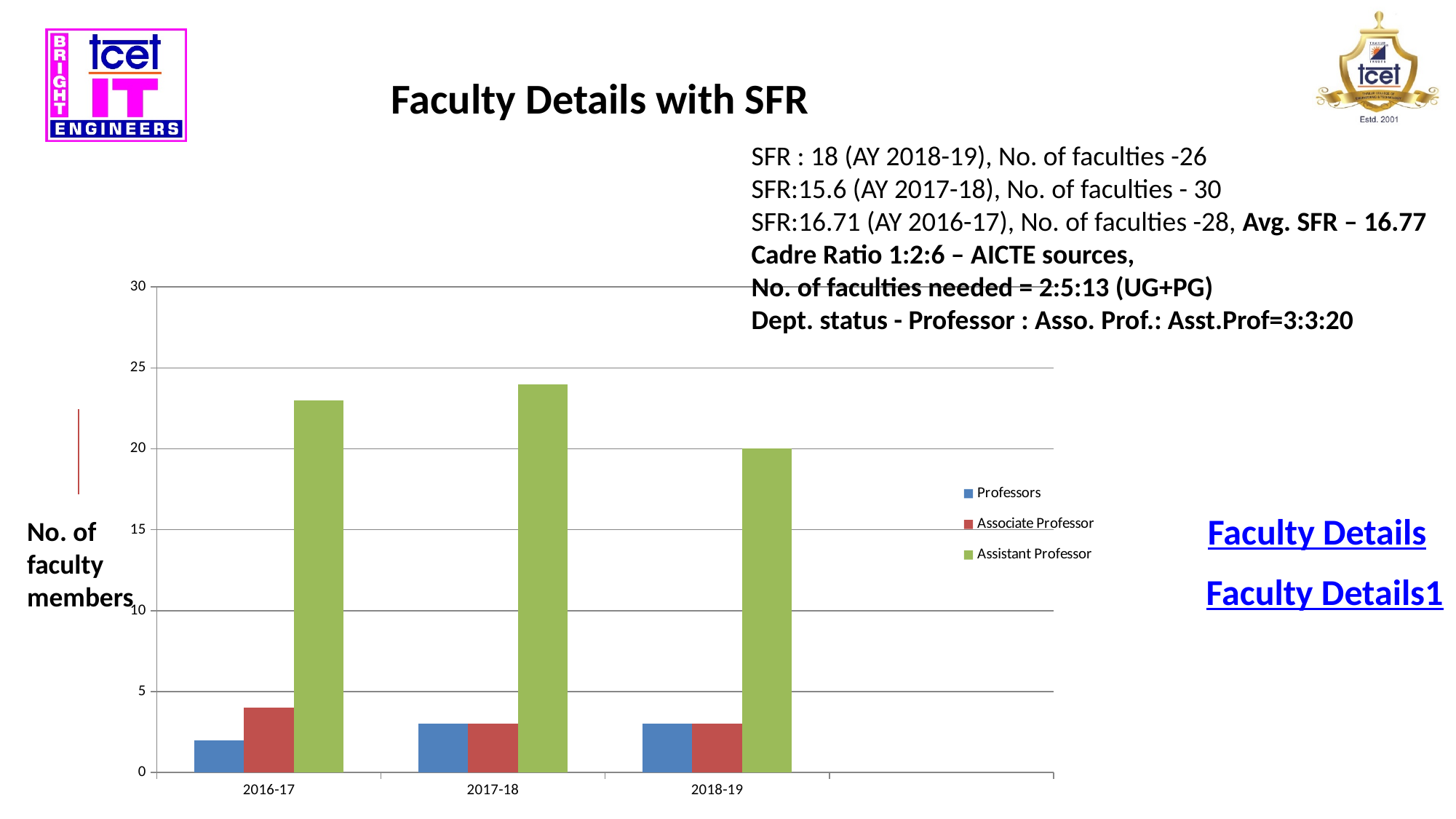
In 2016-17, which is larger: the Professors value or the Associate Professor value? Associate Professor Which is larger: the Assistant Professor value for 2016-17 or for 2018-19? 2016-17 What label is given to the vertical axis of the chart? No. of faculty members Is the Assistant Professor value for 2017-18 greater or less than 25? less How many series does the chart legend list? 3 Is the Professors value for 2016-17 greater or less than 5? less What type of chart is shown on the slide? bar chart What is the Assistant Professor value for 2018-19? 20 In which year is the Assistant Professor value lowest? 2018-19 Is the Assistant Professor value for 2016-17 greater or less than 20? greater How many academic years are shown on the x axis of the chart? 3 Which series has the highest value in every year shown? Assistant Professor